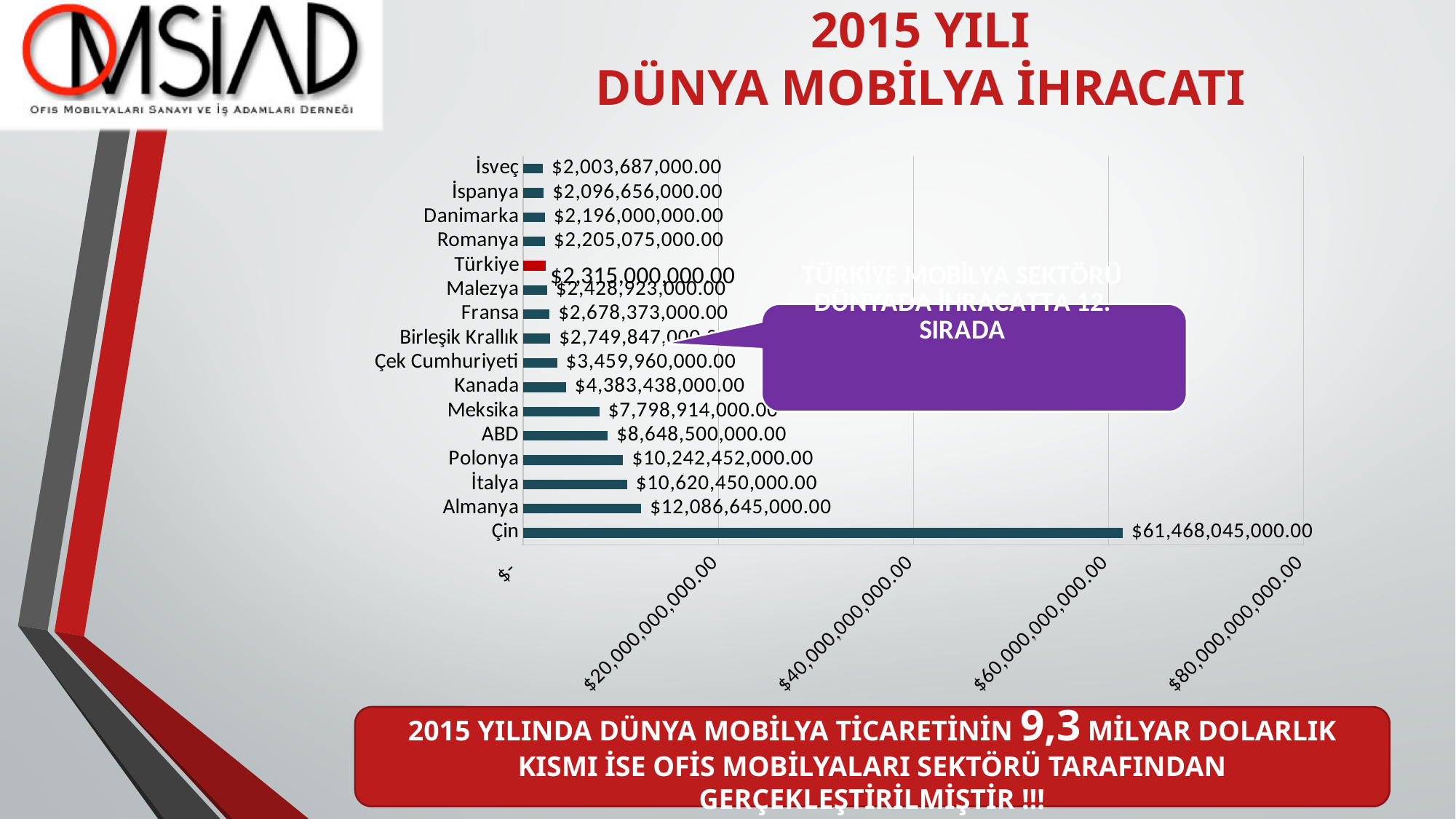
What is the 2015 furniture export value shown for Türkiye? $2,315,000,000.00 What is the export value shown for Almanya? $12,086,645,000.00 What is the difference between the export values of Almanya and İtalya? $1,466,195,000.00 Which country has the lowest furniture export value in the chart? İsveç What type of chart is shown on the slide? Bar chart How many countries are shown in the chart? 16 Which country has the highest furniture export value in the chart? Çin What is the difference between the export values of İtalya and Polonya? $377,998,000.00 What is the export value shown for Çek Cumhuriyeti? $3,459,960,000.00 Is the value for Çin greater or less than $60,000,000,000.00? greater Which has a larger export value, Kanada or Çek Cumhuriyeti? Kanada Which country's bar is coloured red in the chart? Türkiye